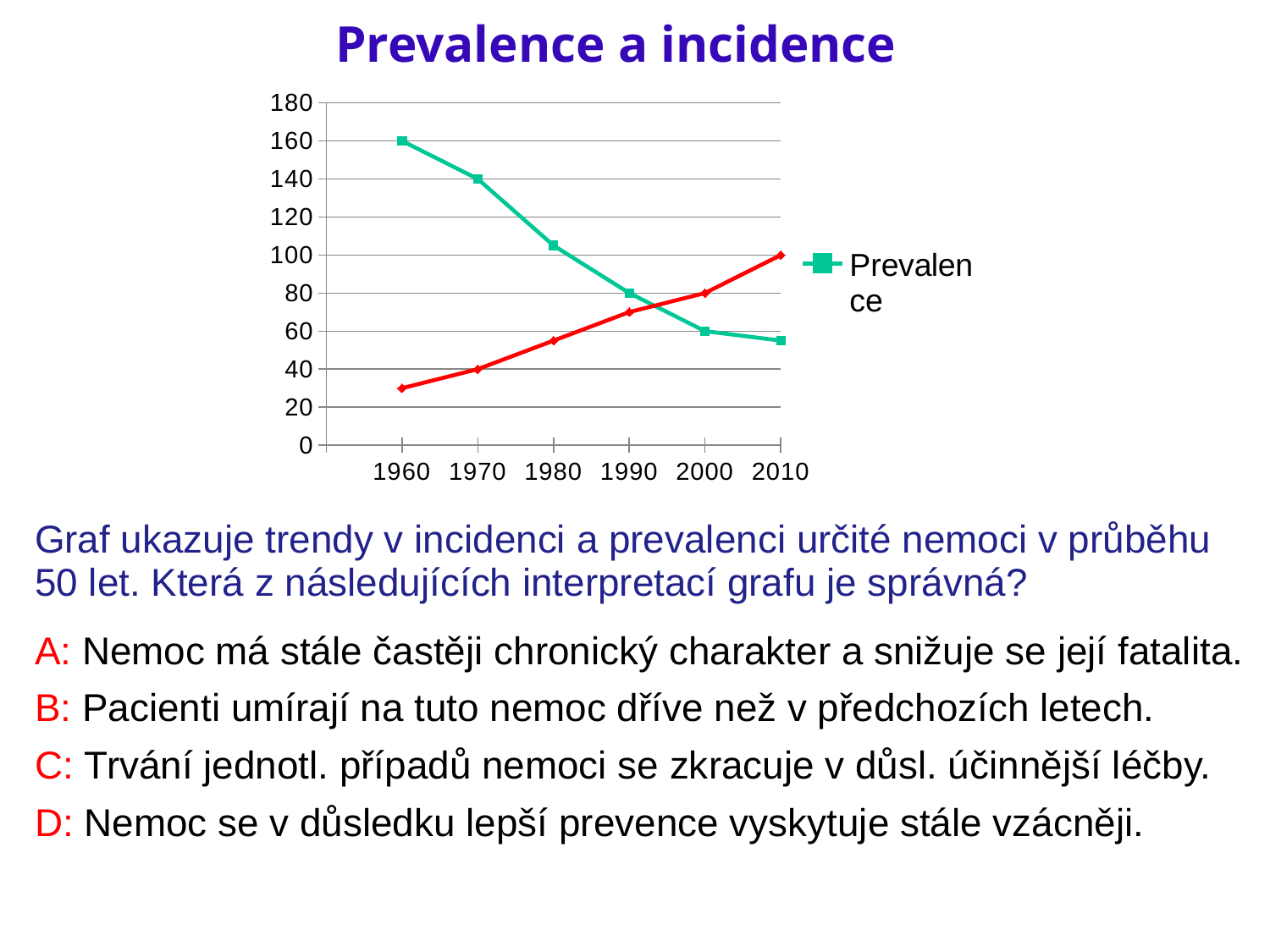
In which year is Prevalence highest? 1960 In which year is Prevalence lowest? 2010 What is the Prevalence value in 1960? 160 What is the title of the chart? Prevalence a incidence What is the Prevalence value in 1970? 140 How many series does the chart's legend list? 1 What kind of chart is shown on the slide? line chart How many years are plotted along the x axis of the chart? 6 Which year has the larger Prevalence value, 1960 or 2010? 1960 Does Prevalence rise or fall from 1960 to 2010? fall